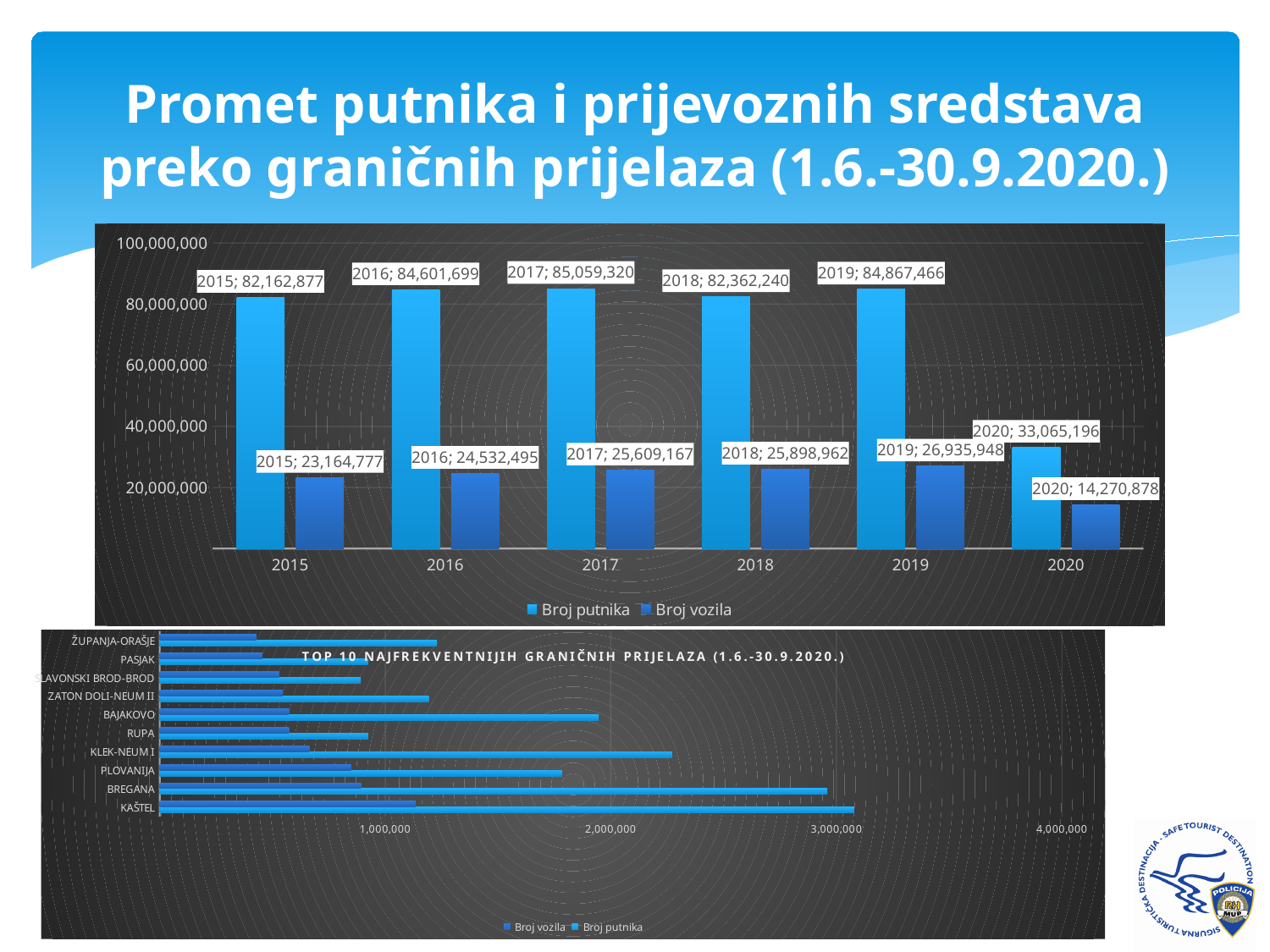
In the top chart, which is larger: Broj putnika in 2018 or in 2019? 2019 In the top chart, what is the difference between Broj putnika in 2019 and in 2020? 51,802,270 In the bottom chart, is the Broj putnika value for RUPA greater or less than 1,000,000? less In the top chart, does Broj vozila rise or fall from 2015 to 2019? rise What type of chart is the bottom chart? bar chart In the top chart, what is the value of Broj putnika for 2017? 85,059,320 In the bottom chart, how many border crossings are listed? 10 In the bottom chart, is the Broj putnika value for KLEK-NEUM I greater or less than 2,000,000? greater In the top chart, how many years are shown on the x axis? 6 In the top chart, which year has the lowest Broj vozila value? 2020 In the top chart, which year has the highest Broj putnika value? 2017 In the top chart, what is the value of Broj vozila for 2020? 14,270,878